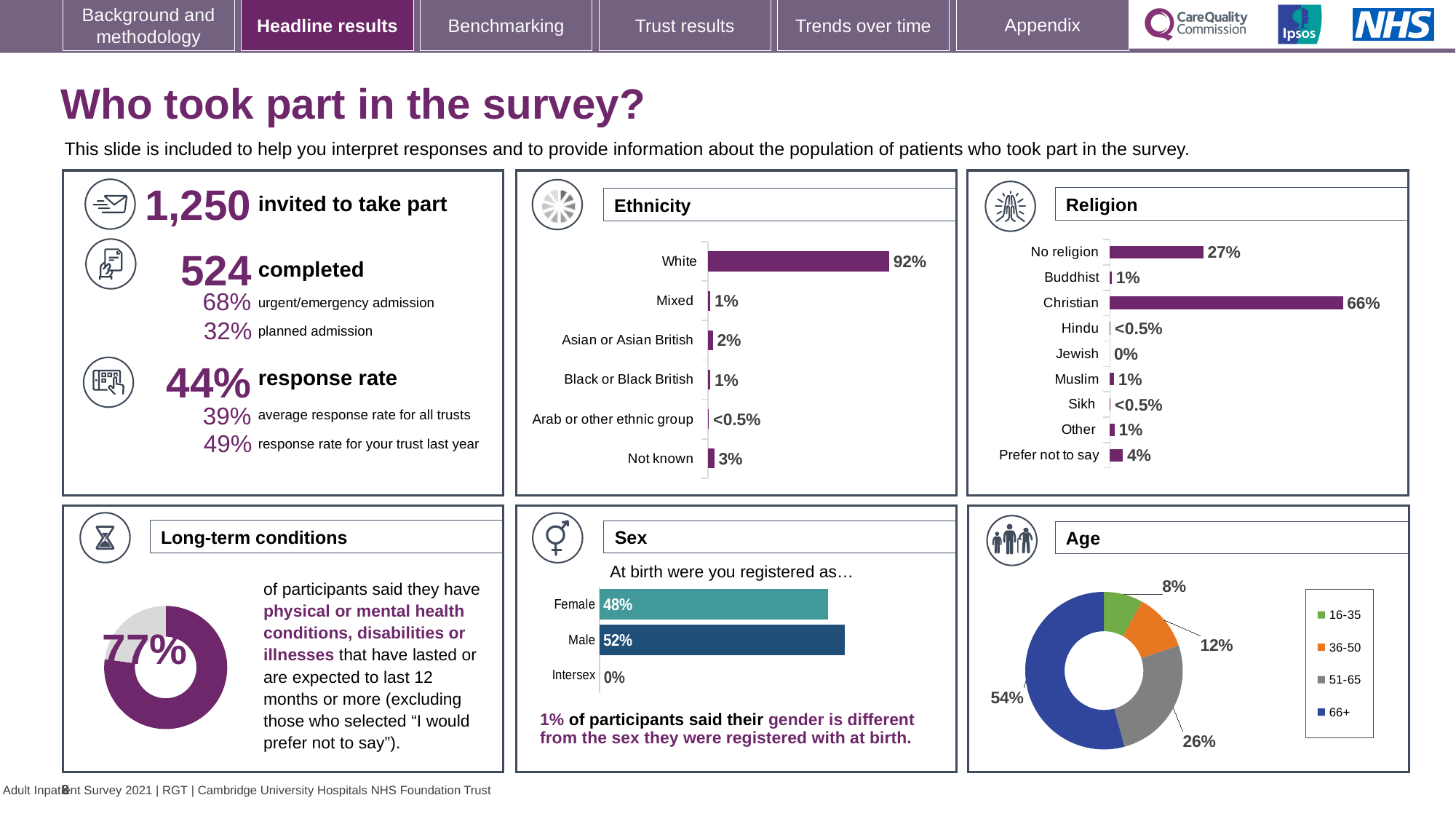
What kind of chart is the Age chart? Donut chart In the Religion chart, which category has the lowest value? Jewish In the Ethnicity chart, which category has the highest value? White In the Ethnicity chart, what percentage of participants were White? 92% How many entries does the legend of the Age chart list? 4 In the Religion chart, what is the difference between the Christian and No religion values? 39% How many categories are shown in the Ethnicity chart? 6 In the Sex chart, which is larger, the Female or the Male value? Male In the Religion chart, what percentage of participants were Christian? 66% In the Ethnicity chart, what is the value for Not known? 3% In the Religion chart, what is the value for Prefer not to say? 4% In the Age chart, what share of participants were aged 66+? 54%